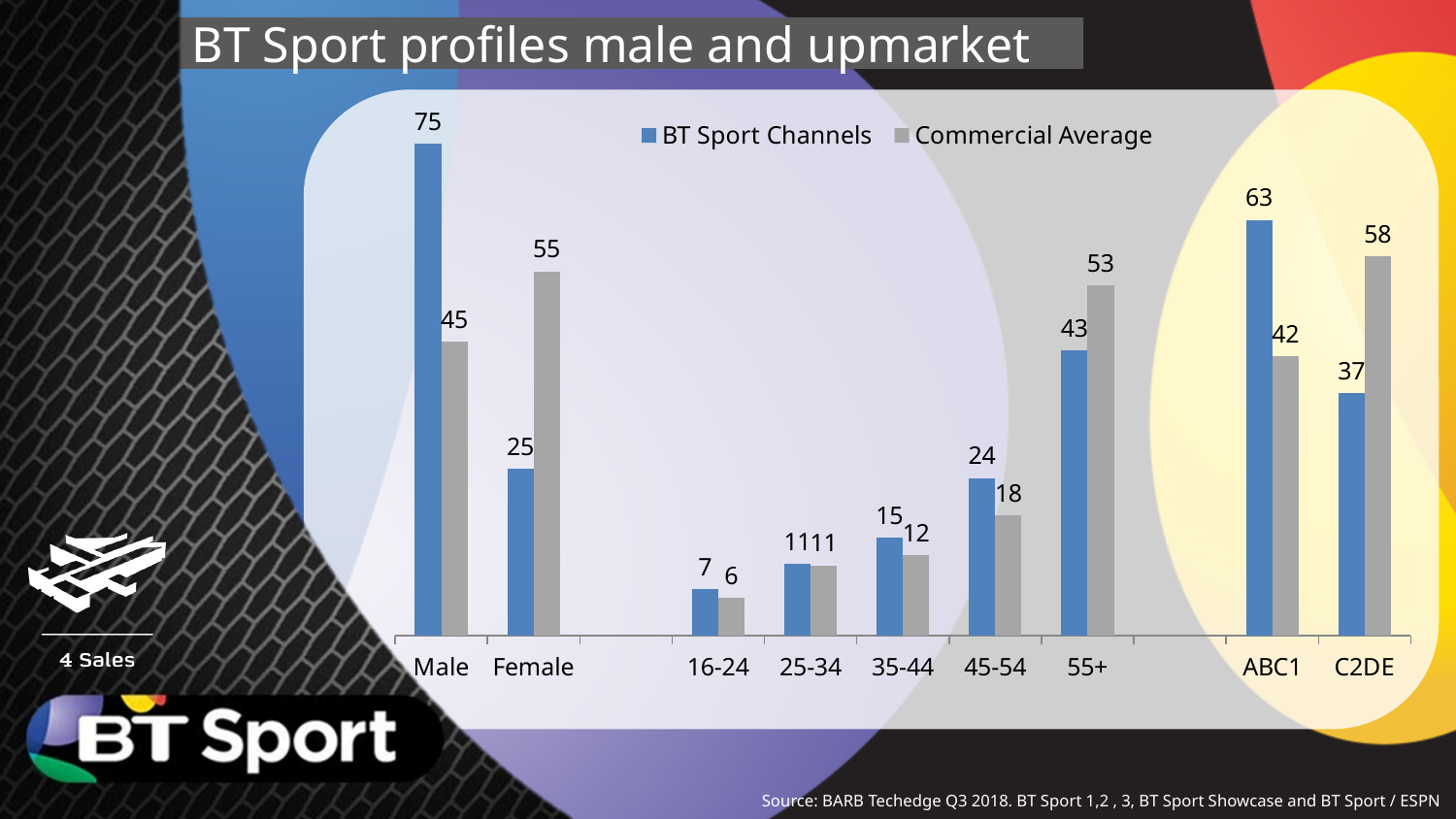
Which is larger for 45-54: BT Sport Channels or Commercial Average? BT Sport Channels What is the Commercial Average value for 55+? 53 Which category has the highest BT Sport Channels value? Male What is the Commercial Average value for Female? 55 Which category has the lowest Commercial Average value? 16-24 What is the difference between the BT Sport Channels and Commercial Average values for Male? 30 What is the BT Sport Channels value for Male? 75 What is the title of the slide? BT Sport profiles male and upmarket What is the difference between the Commercial Average and BT Sport Channels values for C2DE? 21 What is the BT Sport Channels value for ABC1? 63 How many series does the legend list? 2 What kind of chart is shown on the slide? Bar chart